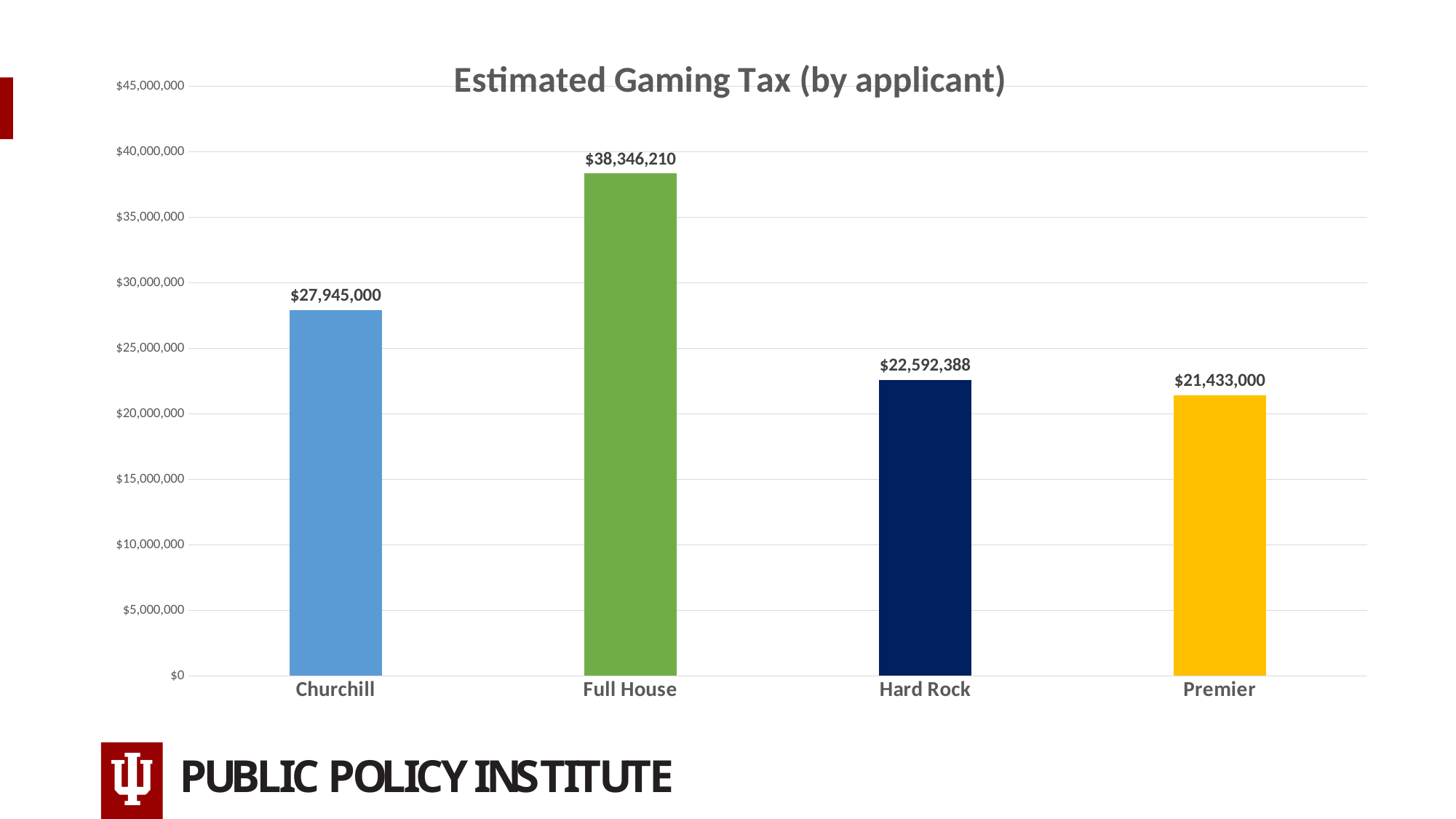
Which applicant has the lowest estimated gaming tax? Premier What is the estimated gaming tax for Hard Rock? $22,592,388 What is the difference between the estimated gaming tax for Hard Rock and Premier? $1,159,388 Which applicant has the highest estimated gaming tax? Full House What is the estimated gaming tax for Full House? $38,346,210 What is the estimated gaming tax for Premier? $21,433,000 What is the difference between the estimated gaming tax for Full House and Churchill? $10,401,210 What type of chart is shown on the slide? Bar chart Which has a larger estimated gaming tax, Churchill or Hard Rock? Churchill Is the value for Premier greater or less than $25,000,000? less How many applicants are shown in the chart? 4 What is the estimated gaming tax for Churchill? $27,945,000